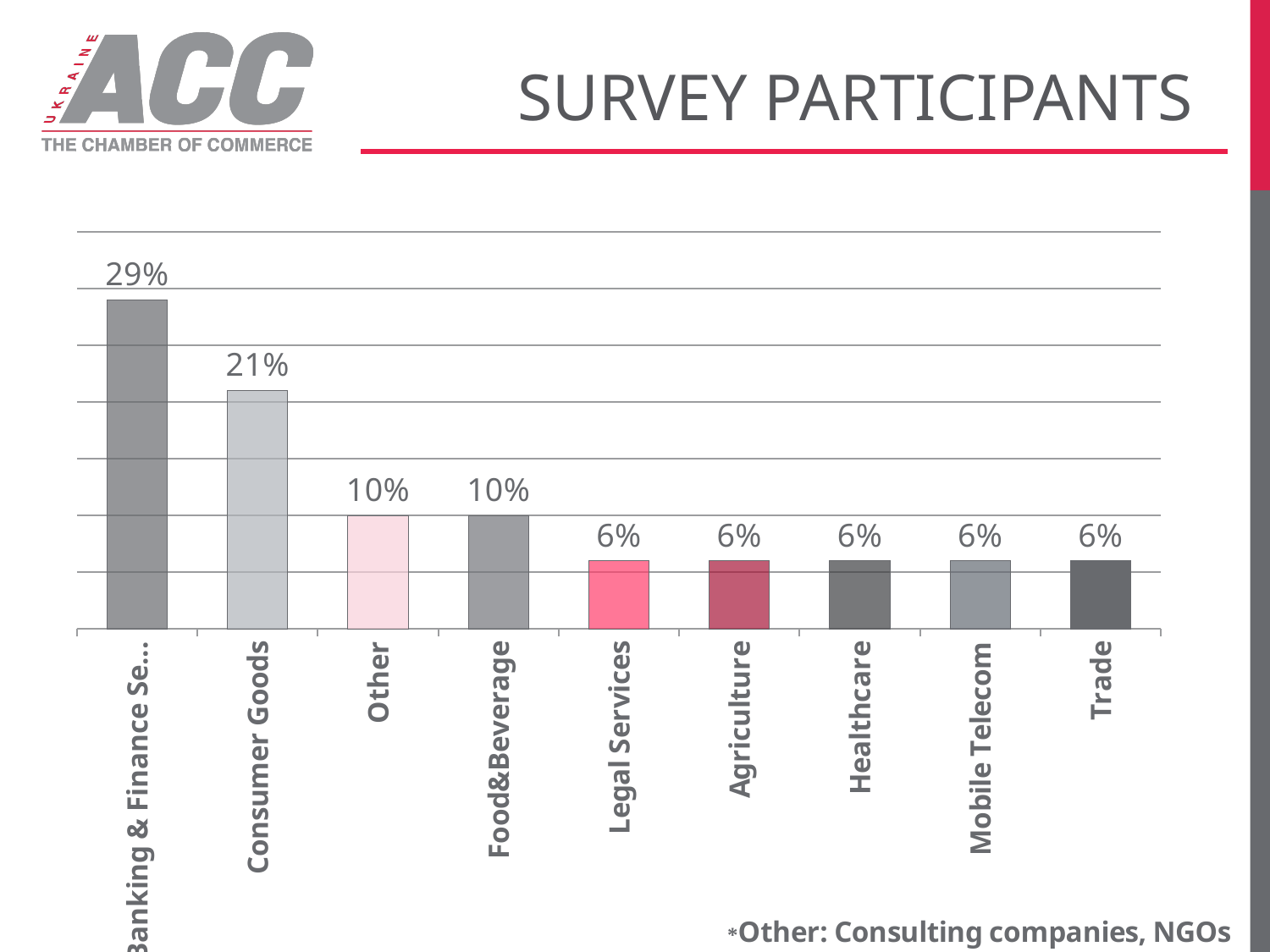
What is the value for the leftmost bar, Banking & Finance? 29% How many categories are shown in the chart? 9 What kind of chart is shown on the slide? bar chart What is the difference between the values for Consumer Goods and Other? 11% Which is larger, the value for Consumer Goods or the value for Food&Beverage? Consumer Goods What is the difference between the values for Banking & Finance and Consumer Goods? 8% What is the value for Consumer Goods? 21% According to the footnote, what does the 'Other' category include? Consulting companies, NGOs What is the value for Mobile Telecom? 6% What is the value for Food&Beverage? 10% Which category has the highest value? Banking & Finance What is the value for Legal Services? 6%